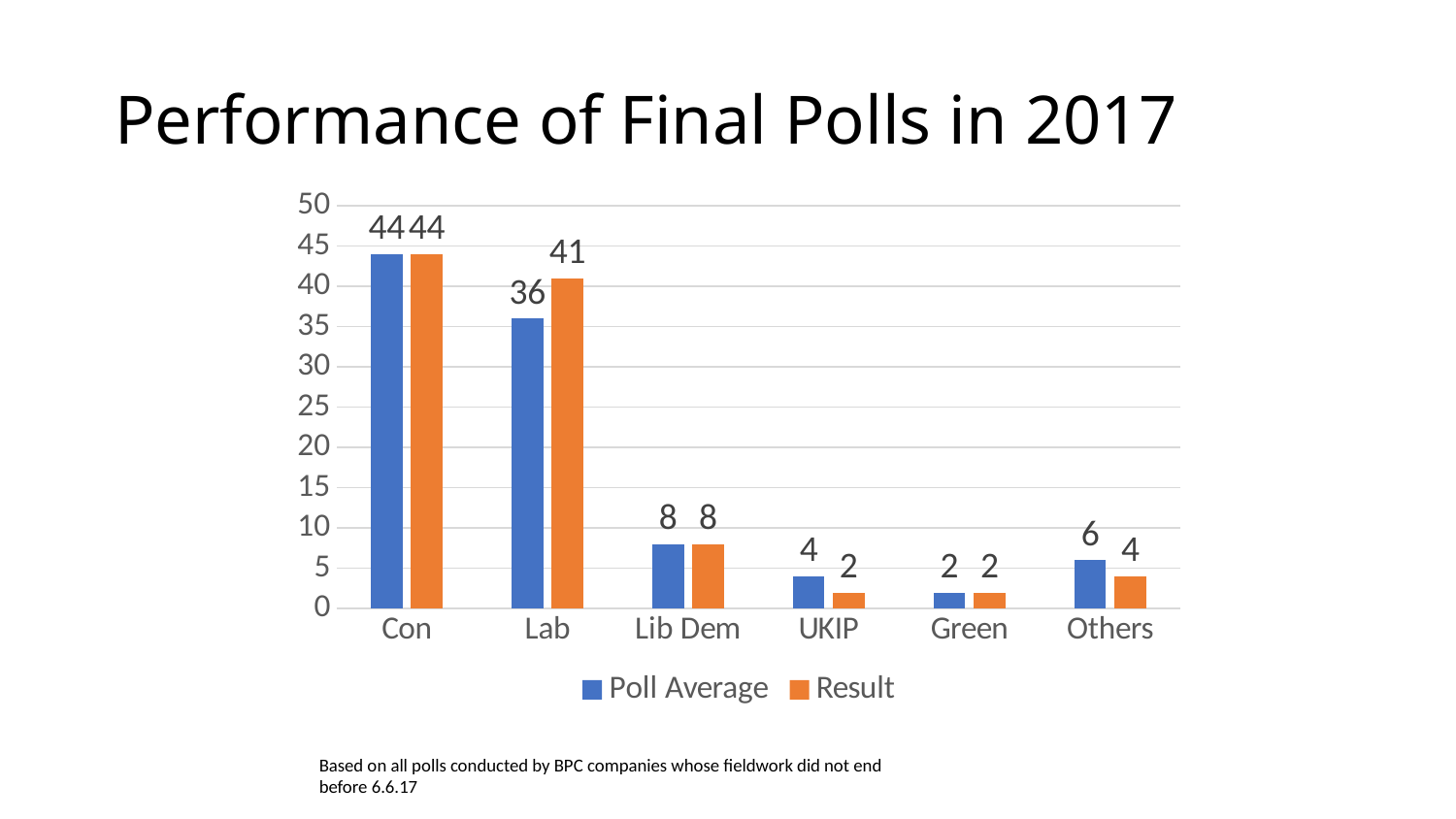
How many series does the legend list? 2 What is the Result value for Lab? 41 What is the Poll Average value for Lab? 36 What kind of chart is shown on the slide? Bar chart What is the Result value for UKIP? 2 What is the Poll Average value for Others? 6 Which is larger for UKIP, the Poll Average or the Result? Poll Average Which category has the highest Result value? Con What is the title of the slide? Performance of Final Polls in 2017 What is the difference between the Result and the Poll Average for Lab? 5 How many categories are shown on the x axis? 6 Which category has the lowest Poll Average value? Green